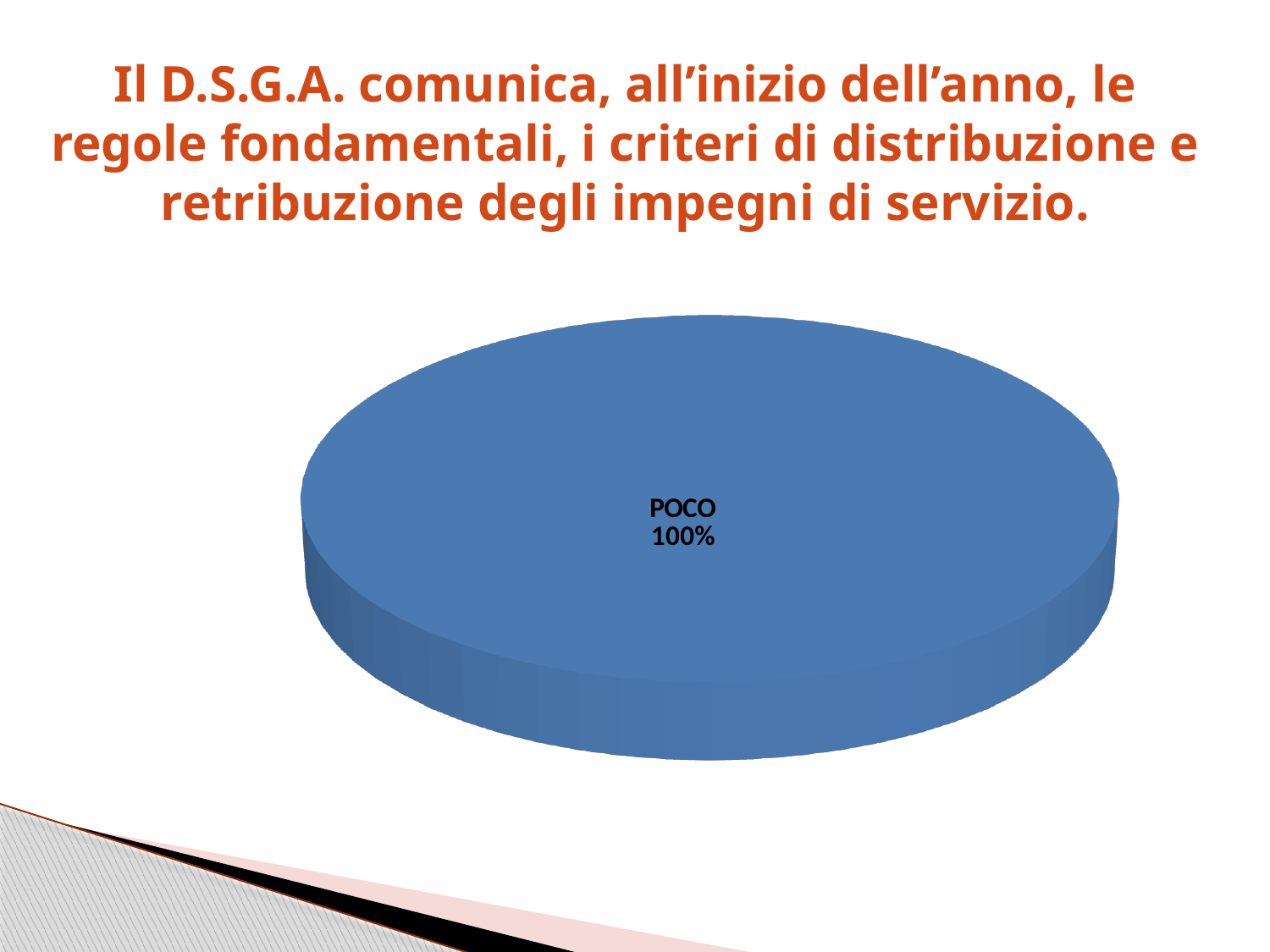
What colour is the POCO slice? blue What share of the pie does the POCO slice represent? 100% How many slices does the pie chart have? 1 What kind of chart is shown on the slide? pie chart Which category has the largest share of the pie? POCO What is the label of the only slice in the pie chart? POCO Is the share for POCO greater or less than 50%? greater